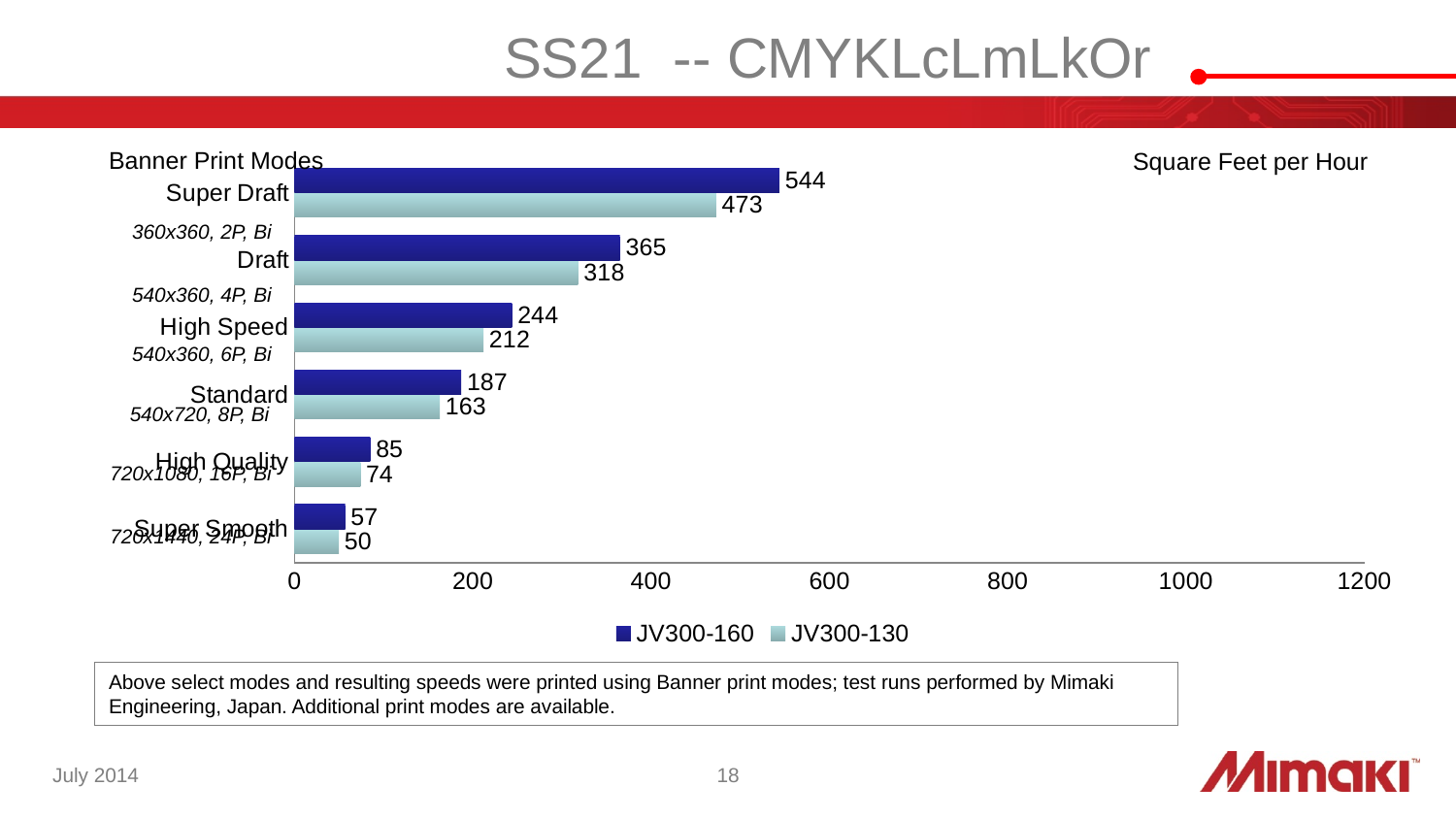
What is the JV300-130 value for Draft? 318 What unit is indicated for the values in the chart? Square Feet per Hour What is the JV300-130 value for Standard? 163 What is the difference between the JV300-160 and JV300-130 values for Super Draft? 71 What is the JV300-160 value for High Speed? 244 How many series does the legend list? 2 Which is larger for High Quality: the JV300-160 value or the JV300-130 value? JV300-160 Which print mode has the highest JV300-160 value? Super Draft What kind of chart is shown on the slide? Bar chart Which print mode has the lowest JV300-130 value? Super Smooth What is the JV300-160 value for Super Draft? 544 How many print modes are shown on the chart? 6